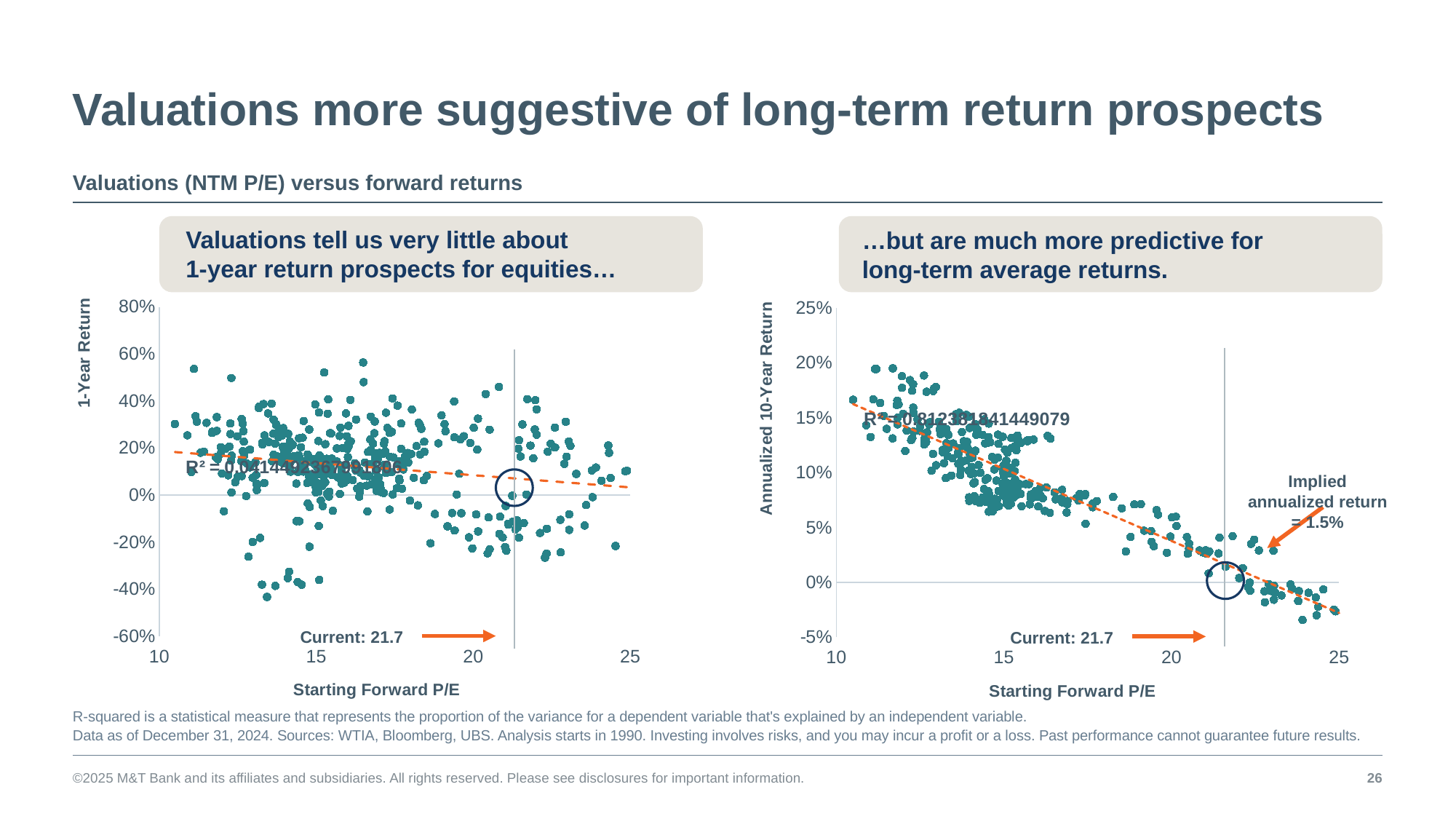
On the left chart, what is the current starting forward P/E marked by the vertical line? 21.7 What is the label of the y-axis on the left chart? 1-Year Return On the right chart, is the implied annualized return at the current P/E of 21.7 greater or less than 5%? less On the left chart, what is the highest value shown on the y-axis? 80% How many charts are shown on the slide? 2 What kind of chart is the left chart, '1-Year Return' versus 'Starting Forward P/E'? Scatter chart Which chart shows the stronger relationship between starting forward P/E and returns, the left (1-year) or the right (10-year)? The right (10-year) chart What kind of chart is the right chart, 'Annualized 10-Year Return' versus 'Starting Forward P/E'? Scatter chart On the right chart, what implied annualized return is labelled at the current P/E? 1.5% On the right chart, what is the lowest value shown on the y-axis? -5% On the right chart, do the annualized 10-year returns rise or fall as the starting forward P/E increases? Fall What is the label of the x-axis on the right chart? Starting Forward P/E